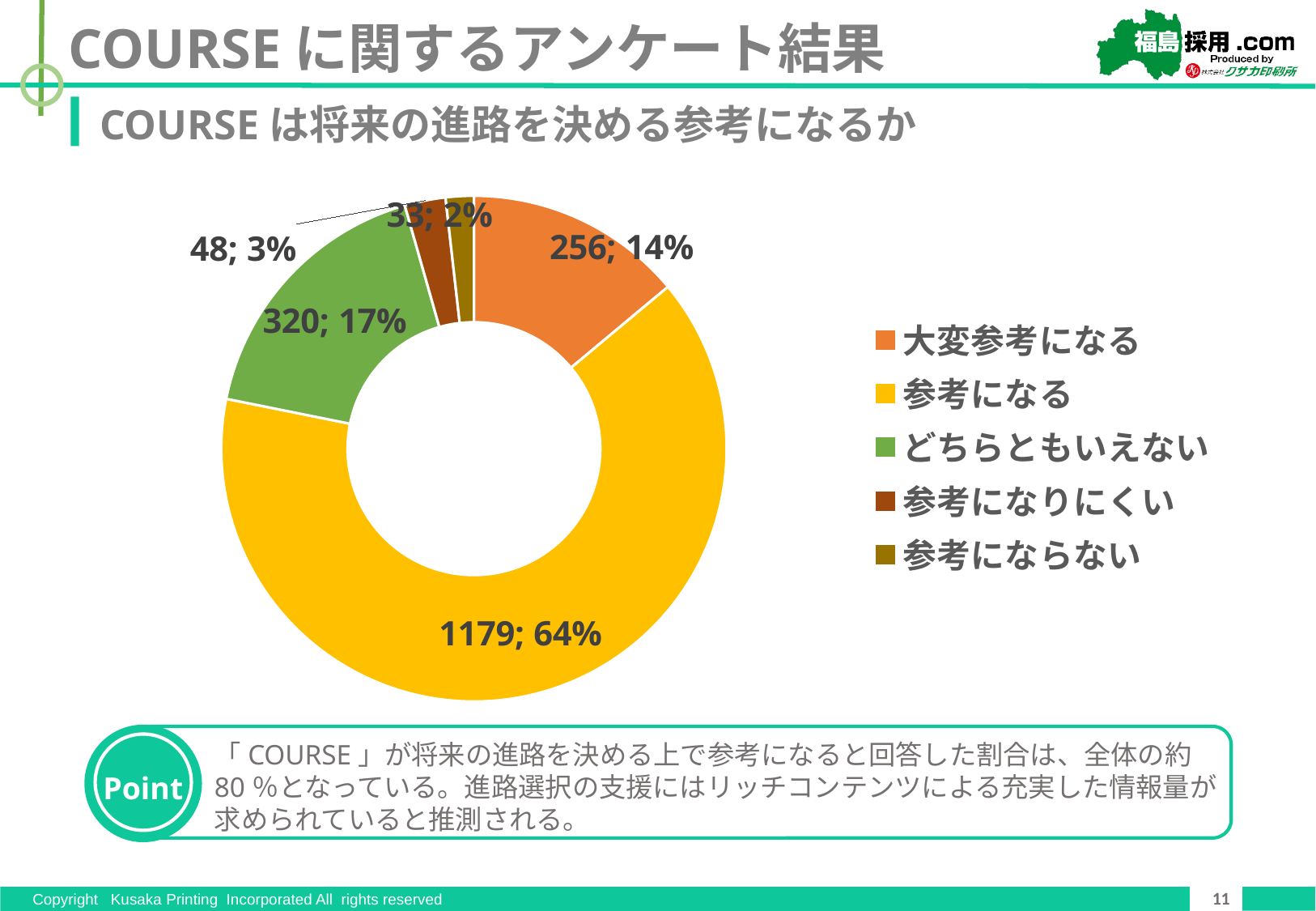
Which category has the smallest share? 参考にならない What colour represents 参考になる in the chart? yellow What is the count for 参考になりにくい? 48 Which has a larger count, どちらともいえない or 大変参考になる? どちらともいえない How many categories does the legend list? 5 What is the count for どちらともいえない? 320 What kind of chart is shown on the slide? doughnut chart What is the count for 参考になる? 1179 What is the difference in count between 参考になる and 大変参考になる? 923 What percentage share does 大変参考になる have? 14% What percentage share does 参考にならない have? 2% Which category has the largest share? 参考になる